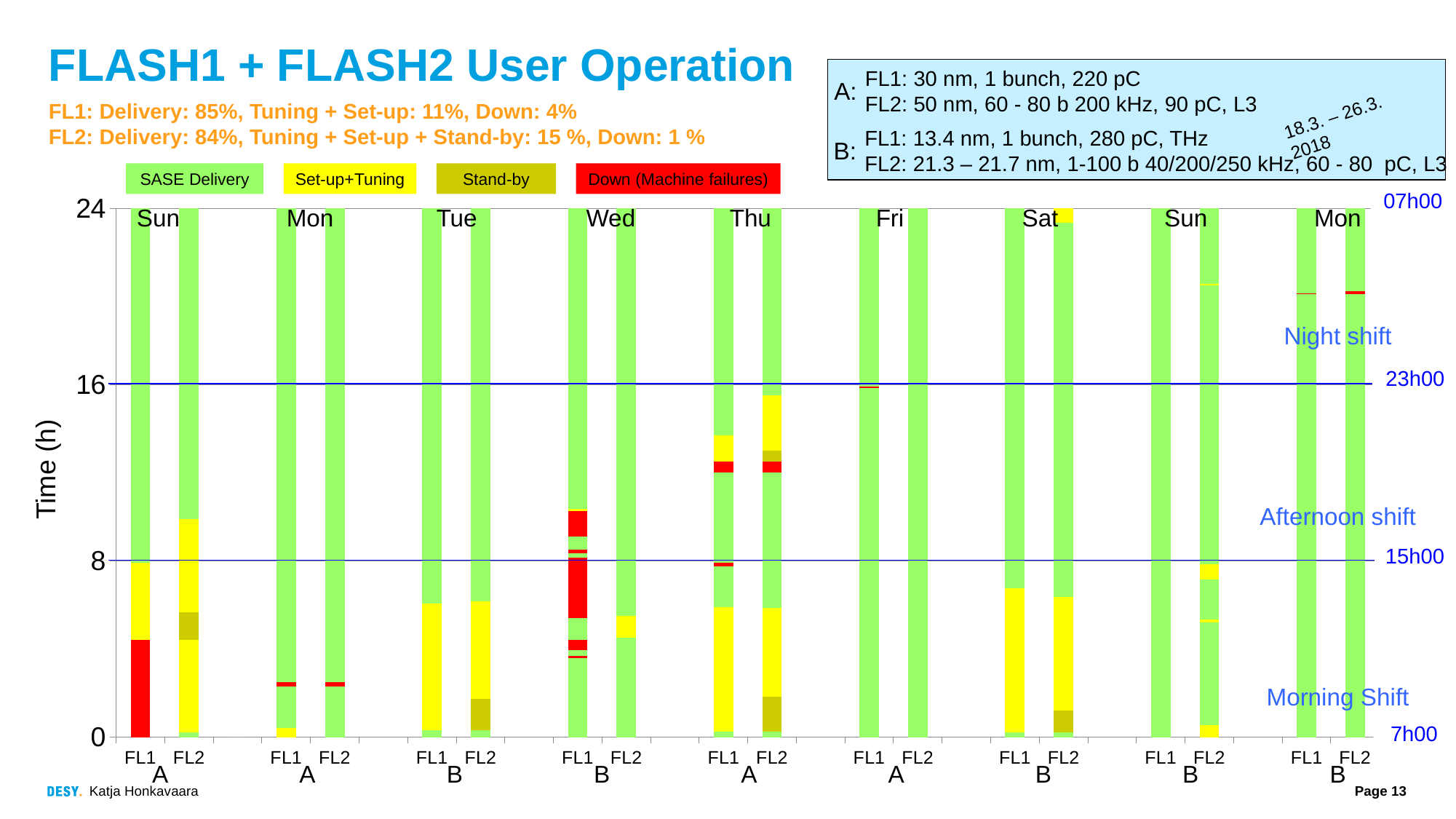
How many bars contain an olive Stand-by segment? 4 Is the top of the yellow Set-up+Tuning segment in the first Sun FL2 bar greater or less than 8 hours? greater Which legend entry is shown in red? Down (Machine failures) What kind of chart is shown on the slide? stacked bar chart What is the label of the y axis of the chart? Time (h) What is the highest tick value shown on the y axis of the chart? 24 How many entries does the chart legend list? 4 Which bar has more green SASE Delivery time: Fri FL1 or the first Sun FL1? Fri FL1 Is the green SASE Delivery portion of the Fri FL2 bar greater or less than 16 hours? greater Is the top of the red Down segment in the first Sun FL1 bar greater or less than 8 hours? less How many bars are plotted in the chart in total (FL1 and FL2 for every day)? 18 How many days are labelled along the x axis of the chart? 9